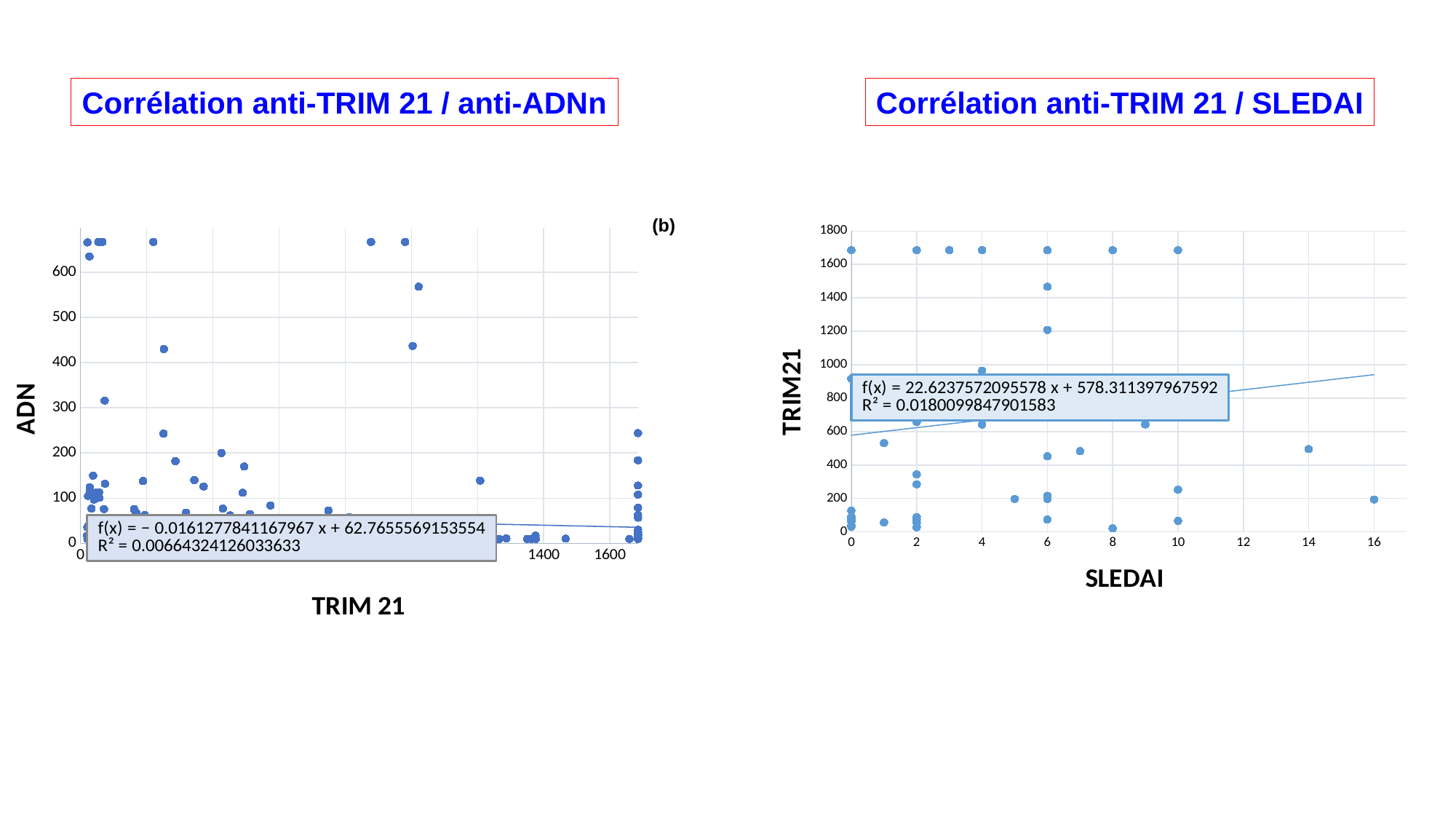
In the chart titled "Corrélation anti-TRIM 21 / SLEDAI", does the trendline rise or fall as SLEDAI increases? Rises What kind of chart is the chart titled "Corrélation anti-TRIM 21 / anti-ADNn"? Scatter chart What is the label of the x axis in the chart titled "Corrélation anti-TRIM 21 / SLEDAI"? SLEDAI In the chart titled "Corrélation anti-TRIM 21 / SLEDAI", what is the R² value shown for the trendline? 0.0180099847901583 In the chart titled "Corrélation anti-TRIM 21 / SLEDAI", is the TRIM21 value of the point at SLEDAI 16 greater or less than 400? less In the chart titled "Corrélation anti-TRIM 21 / anti-ADNn", what is the R² value shown for the trendline? 0.00664324126033633 In the chart titled "Corrélation anti-TRIM 21 / SLEDAI", which of the two R² values on the slide is larger: this chart's or the one in "Corrélation anti-TRIM 21 / anti-ADNn"? Corrélation anti-TRIM 21 / SLEDAI In the chart titled "Corrélation anti-TRIM 21 / SLEDAI", is the TRIM21 value of the point at SLEDAI 14 greater or less than 600? less What kind of chart is the chart titled "Corrélation anti-TRIM 21 / SLEDAI"? Scatter chart In the chart titled "Corrélation anti-TRIM 21 / SLEDAI", is the TRIM21 value of the point at SLEDAI 7 greater or less than 400? greater In the chart titled "Corrélation anti-TRIM 21 / anti-ADNn", does the trendline rise or fall as TRIM 21 increases? Falls What is the label of the y axis in the chart titled "Corrélation anti-TRIM 21 / anti-ADNn"? ADN